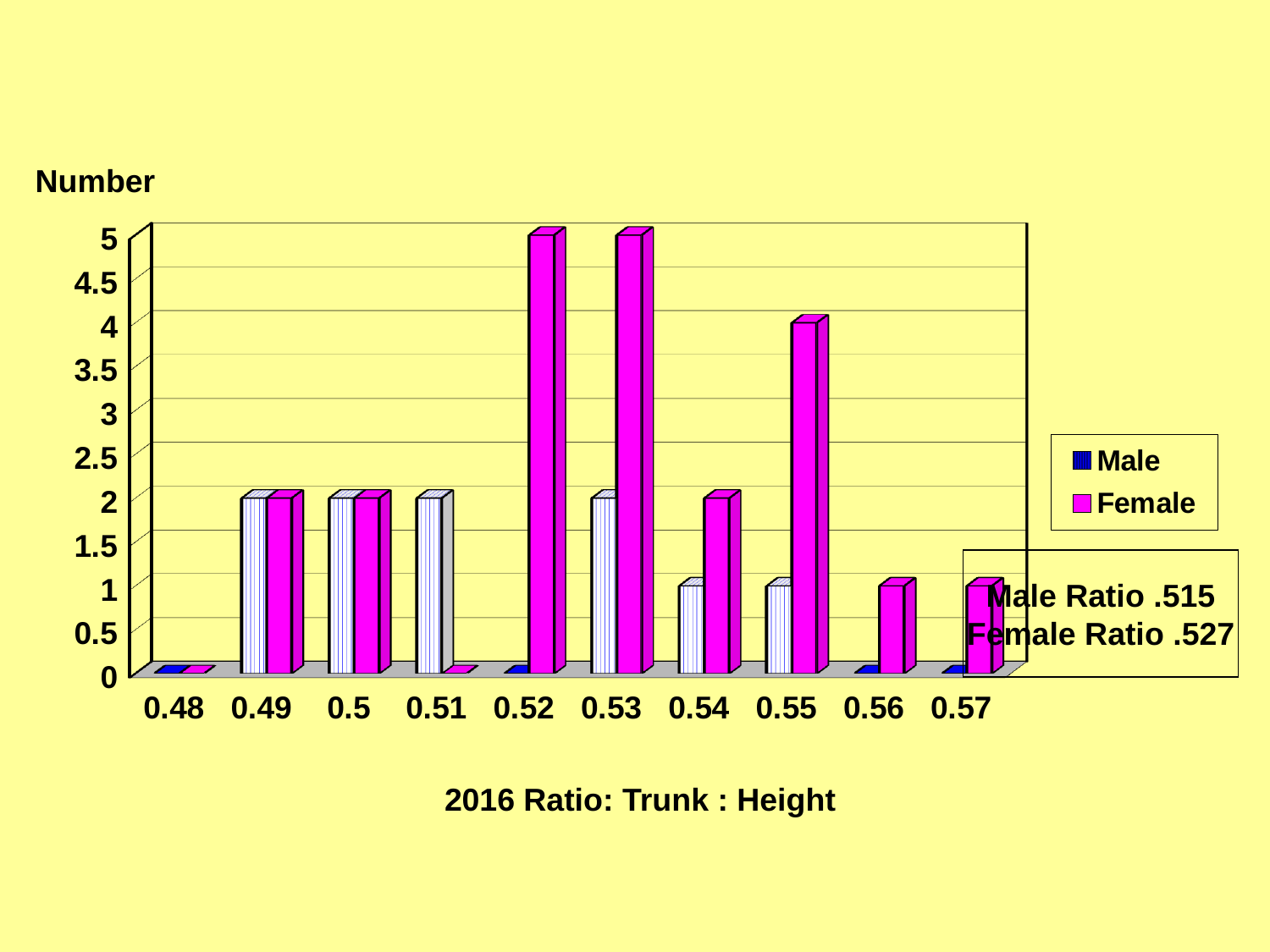
What kind of chart is shown on the slide? bar chart What is the Female value at ratio 0.56? 1 How many ratio categories are shown along the x axis? 10 What is the Female value at ratio 0.52? 5 How many series does the legend list? 2 What is the difference between the Female value at 0.55 and the Female value at 0.54? 2 Which is larger, the Female value at 0.55 or the Female value at 0.54? 0.55 What is the Male Ratio stated in the text box on the chart? .515 Is the Female value at ratio 0.55 greater or less than 3? greater What is the title shown below the x axis of the chart? 2016 Ratio: Trunk : Height What is the Male value at ratio 0.54? 1 What is the Female value at ratio 0.55? 4